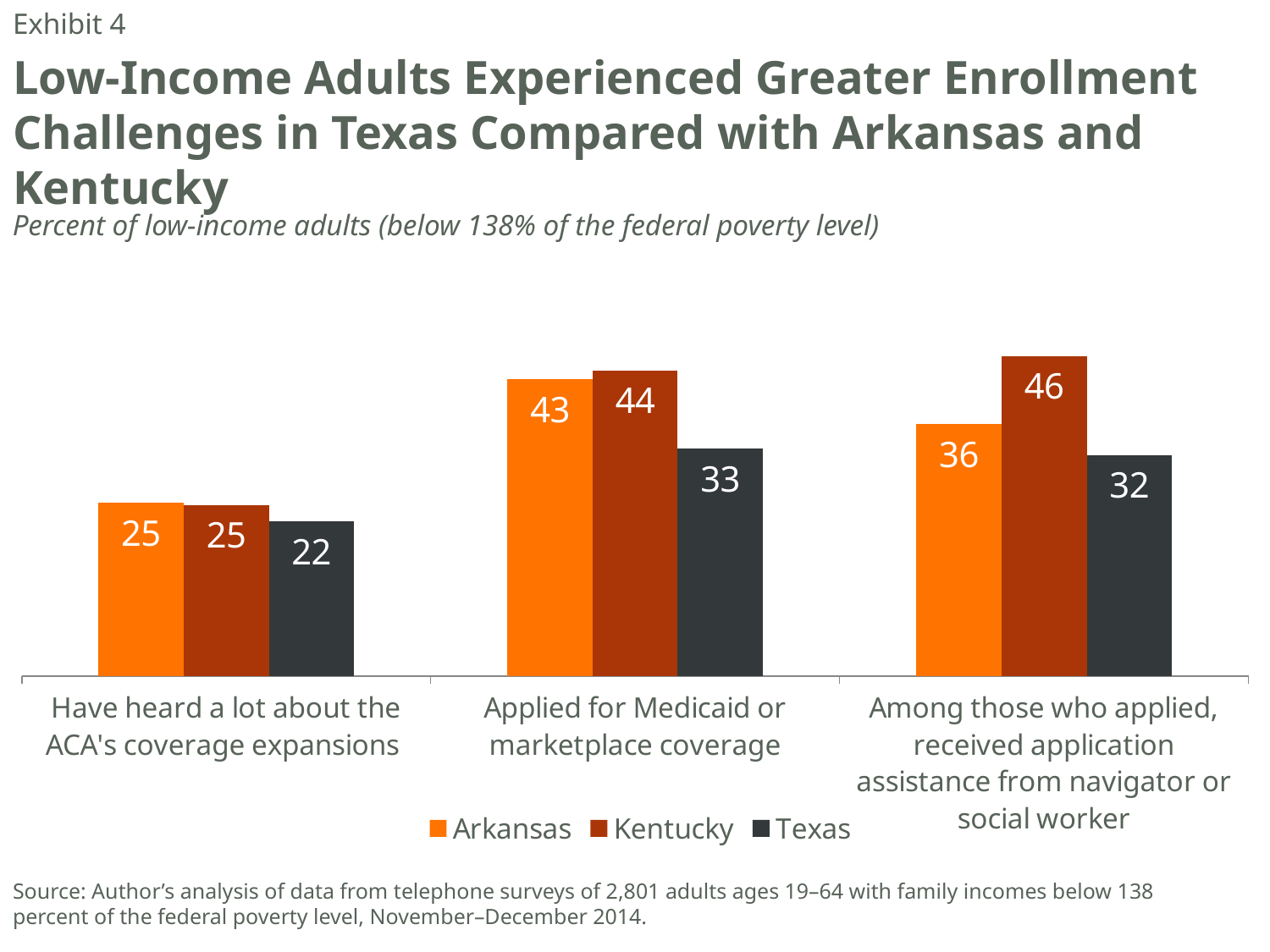
How many series does the legend list? 3 What kind of chart is shown on the slide? Bar chart Which state has the highest value for 'Among those who applied, received application assistance from navigator or social worker'? Kentucky How many categories are shown on the x axis? 3 What is the value for Arkansas in the 'Have heard a lot about the ACA's coverage expansions' category? 25 What is the difference between Kentucky and Texas for 'Among those who applied, received application assistance from navigator or social worker'? 14 Which series is shown in the darkest colour in the legend? Texas Which is larger: the Arkansas value or the Texas value for 'Have heard a lot about the ACA's coverage expansions'? Arkansas What percent of low-income adults in Texas applied for Medicaid or marketplace coverage? 33 Which state has the lowest value for 'Applied for Medicaid or marketplace coverage'? Texas What is the value for Kentucky in the 'Among those who applied, received application assistance from navigator or social worker' category? 46 What is the difference between Arkansas and Texas for 'Applied for Medicaid or marketplace coverage'? 10